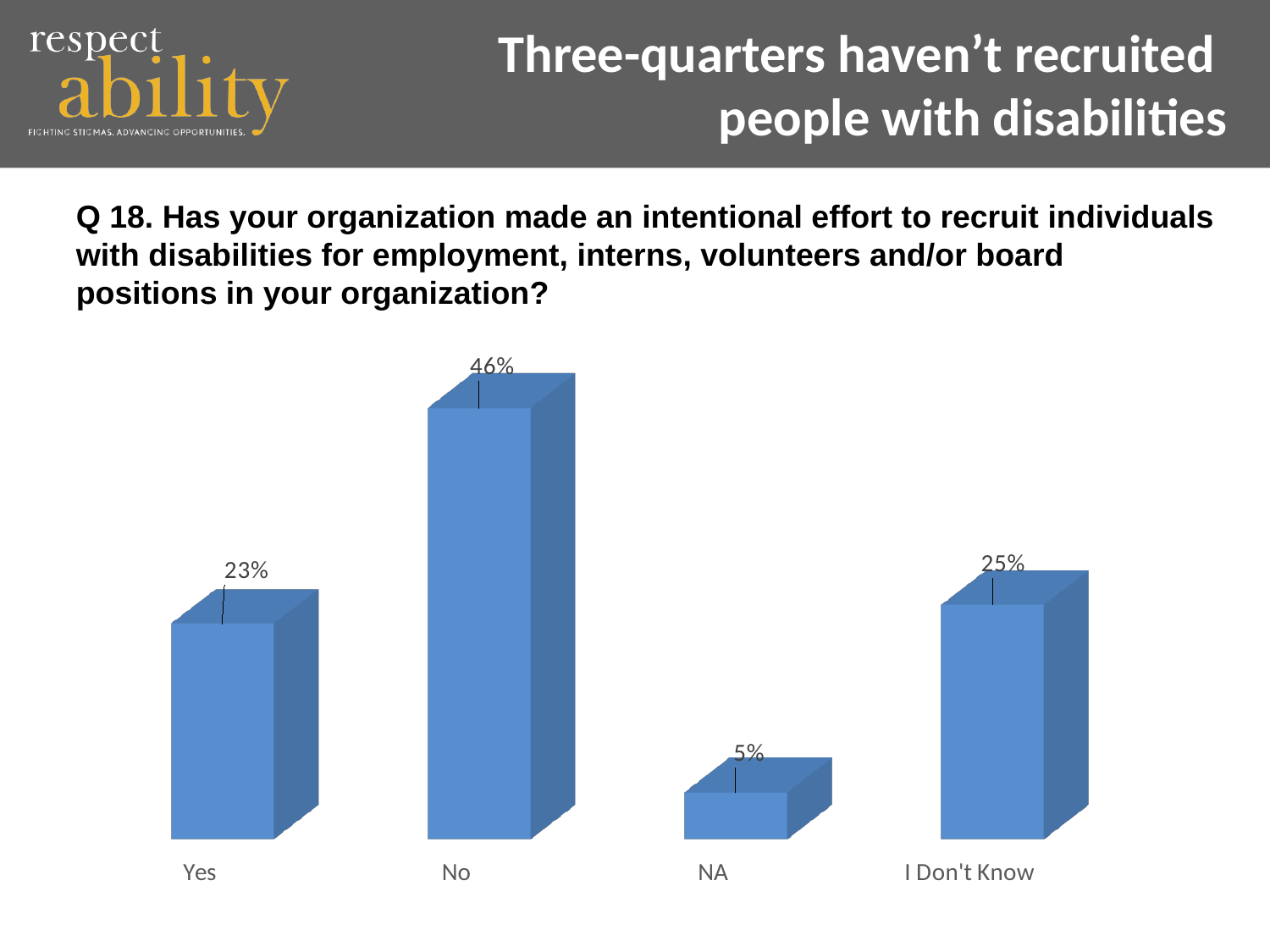
What type of chart is shown on the slide? Bar chart Which response category has the lowest percentage? NA What percentage of respondents answered "No"? 46% What is the title of the slide? Three-quarters haven't recruited people with disabilities What percentage of respondents answered "NA"? 5% What is the difference in percentage points between "No" and "Yes"? 23 Which is larger, the percentage for "Yes" or for "I Don't Know"? I Don't Know Which response category has the highest percentage? No What percentage of respondents answered "I Don't Know"? 25% How many response categories are shown in the chart? 4 What percentage of respondents answered "Yes"? 23% What is the difference in percentage points between "I Don't Know" and "NA"? 20